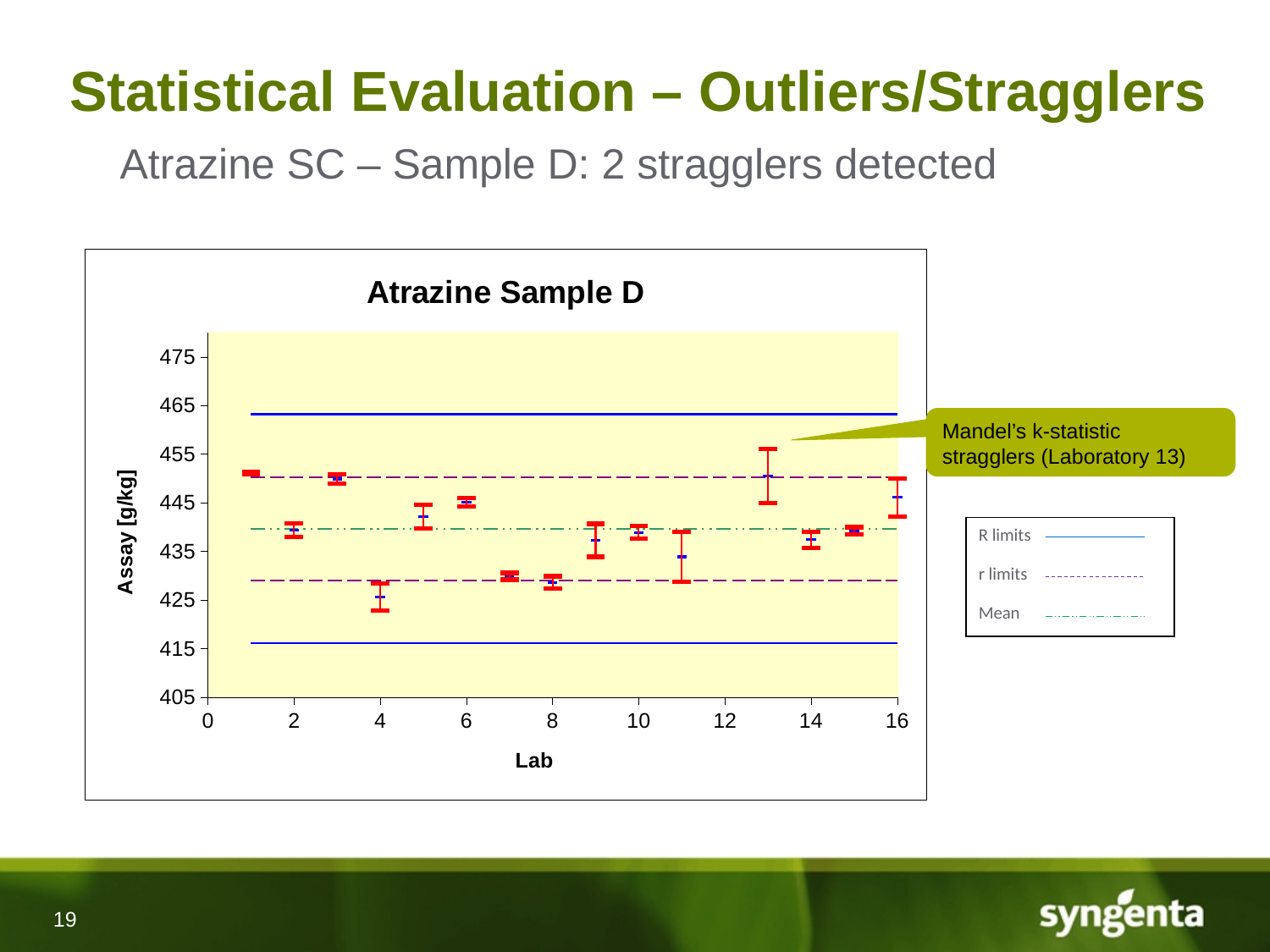
What is the title of the chart? Atrazine Sample D Is the assay value for Lab 7 greater or less than 435? less Is the assay value for Lab 6 greater or less than 435? greater How many labs are plotted on the chart? 15 How many series does the chart's legend list? 3 Is the assay value for Lab 1 greater or less than 445? greater Which has the larger assay value, Lab 1 or Lab 8? Lab 1 What is the label of the y axis? Assay [g/kg] Which lab has the lowest assay value? Lab 4 What kind of chart is shown on the slide? Scatter chart with error bars Which has the larger assay value, Lab 4 or Lab 6? Lab 6